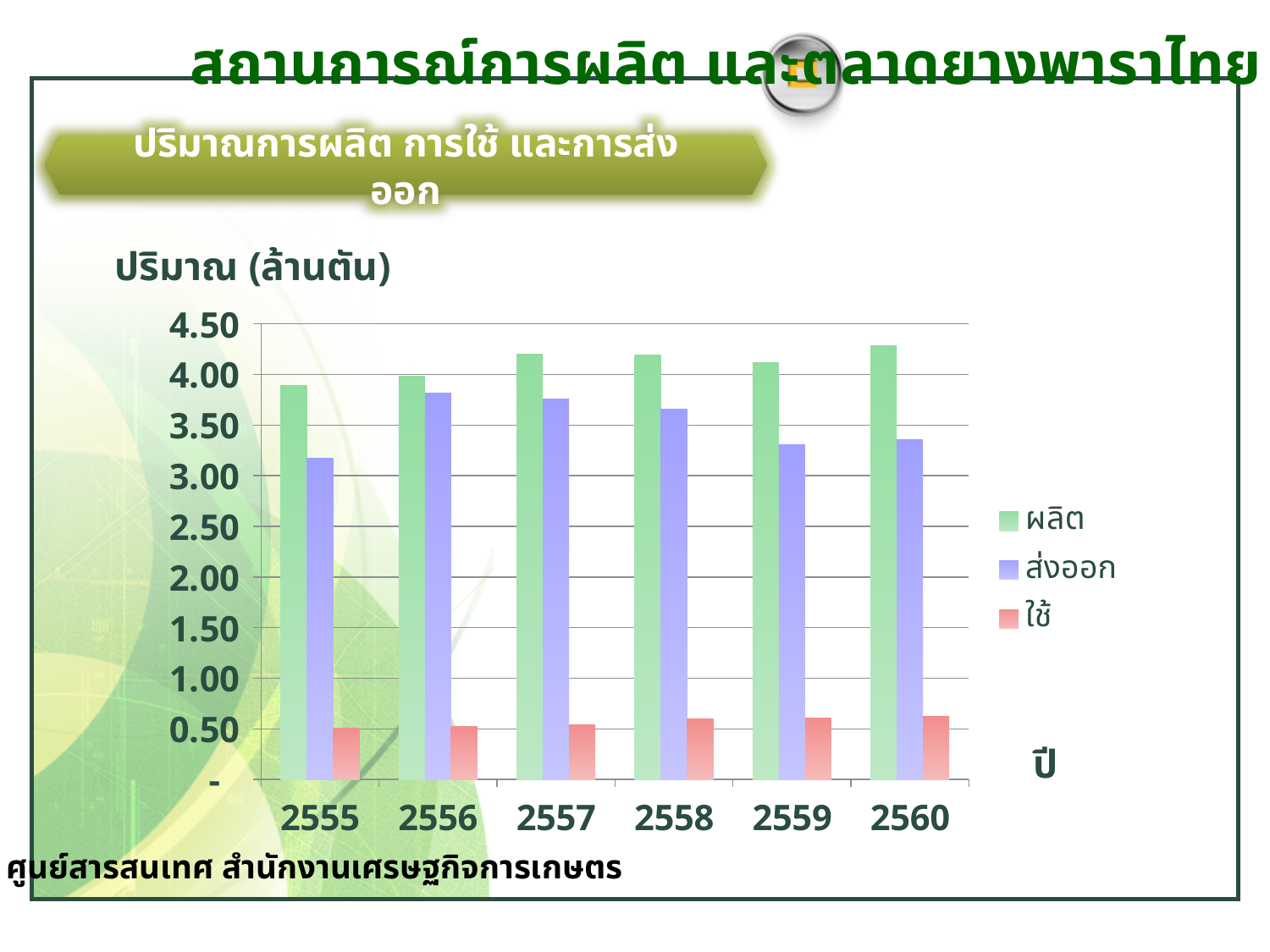
How many years are shown on the x axis of the chart? 6 Is the value for ผลิต in 2557 greater or less than 4.00? greater What colour are the bars for the ผลิต series? green Does the value for ใช้ rise or fall from 2555 to 2560? rise How many series does the chart's legend list? 3 Which is larger, the value for ส่งออก in 2556 or in 2559? 2556 Is the value for ใช้ in 2560 greater or less than 0.50? greater Is the value for ส่งออก in 2555 greater or less than 3.00? greater What kind of chart is shown on the slide? bar chart Which year has the lowest value for ผลิต? 2555